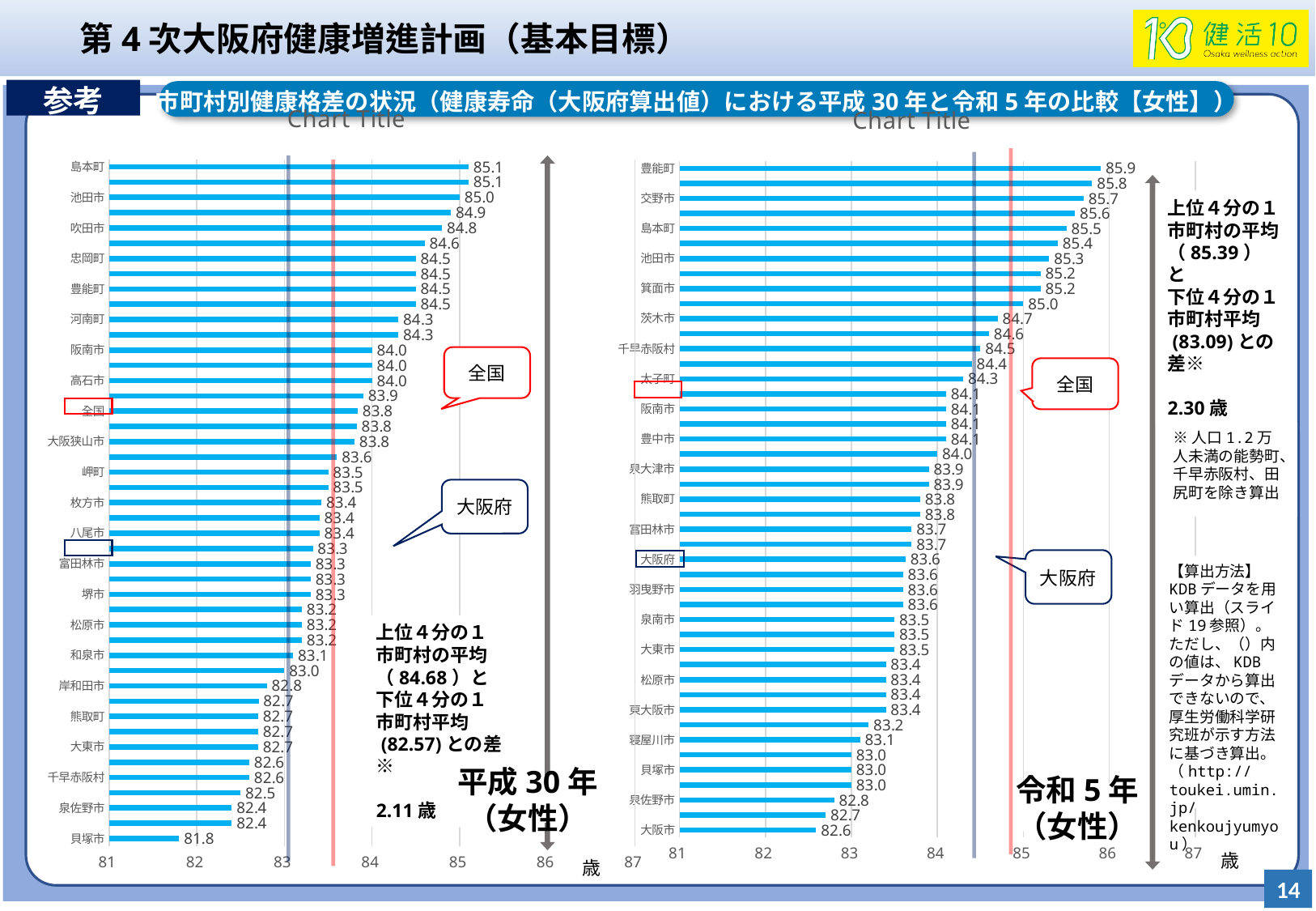
In the 令和5年（女性） chart on the right, what is the value for 池田市? 85.3 In the 令和5年（女性） chart on the right, which is larger, the value for 交野市 or the value for 茨木市? 交野市 What kind of chart is the 平成30年（女性） chart on the left? bar chart In the 令和5年（女性） chart on the right, which municipality has the lowest value? 大阪市 In the 令和5年（女性） chart on the right, what is the value for 大阪府? 83.6 In the 平成30年（女性） chart on the left, is the value for 貝塚市 greater or less than 82? less In the 令和5年（女性） chart on the right, which municipality has the highest value? 豊能町 In the 平成30年（女性） chart on the left, what is the value for 吹田市? 84.8 In the 平成30年（女性） chart on the left, what is the value for 全国? 83.8 In the 平成30年（女性） chart on the left, which municipality has the lowest value? 貝塚市 In the 令和5年（女性） chart on the right, what is the difference between the values for 豊能町 and 大阪市? 3.3 What unit is shown at the end of the x axis of both charts? 歳